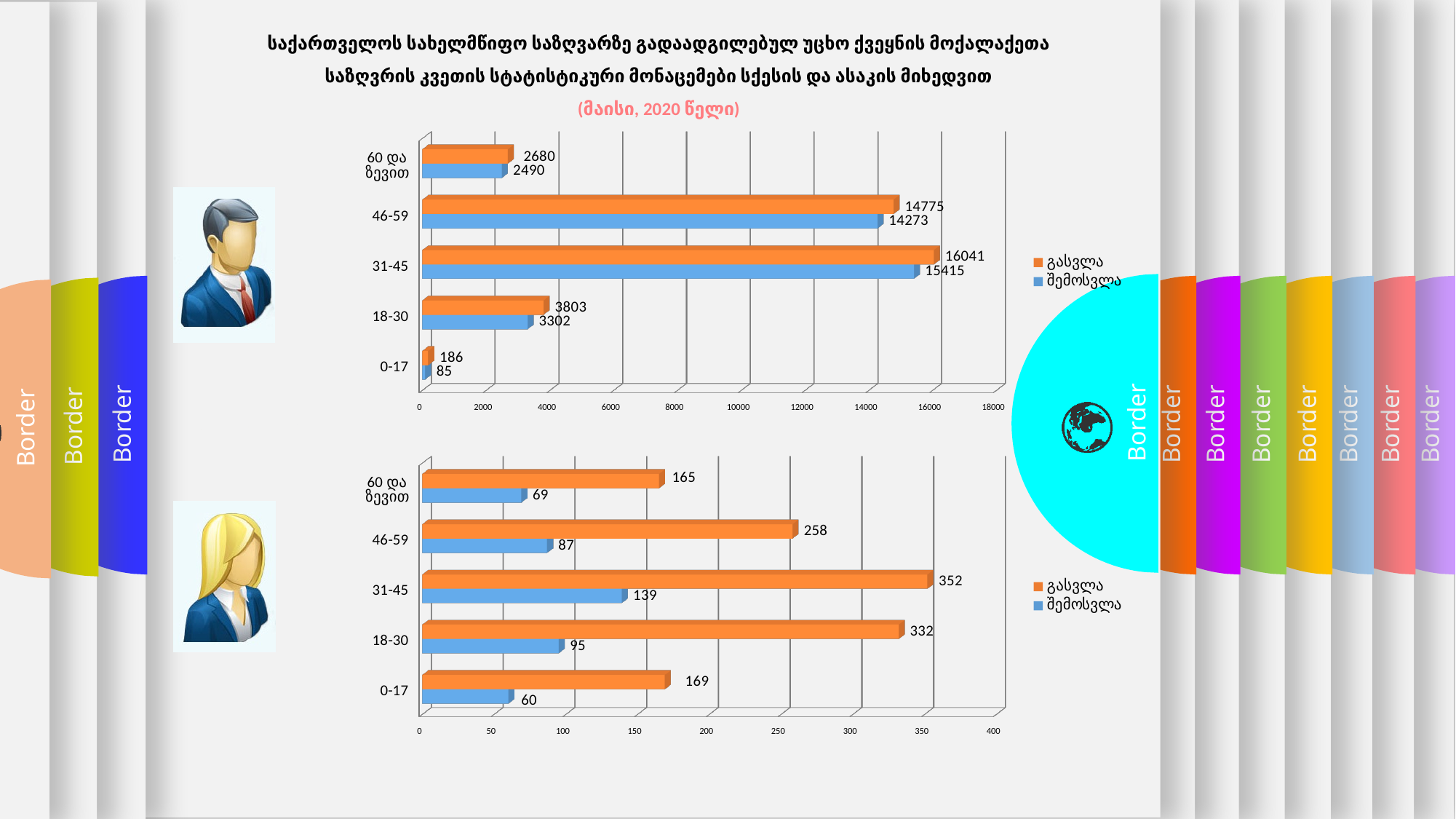
How many age groups are shown in the top chart? 5 In the bottom chart, what is the difference between გასვლა and შემოსვლა for the 31-45 age group? 213 In the bottom chart, which age group has the lowest შემოსვლა value? 0-17 How many series does the legend of the bottom chart list? 2 In the top chart, what is the value of შემოსვლა for the 0-17 age group? 85 What type of chart is the top chart? Bar chart In the top chart, what is the value of გასვლა for the 31-45 age group? 16041 In the top chart, what is the difference between გასვლა and შემოსვლა for the 46-59 age group? 502 In the bottom chart, what is the value of შემოსვლა for the 18-30 age group? 95 In the bottom chart, which is larger: გასვლა for 18-30 or გასვლა for 60 და ზევით? გასვლა for 18-30 In the bottom chart, what is the value of გასვლა for the 46-59 age group? 258 In the top chart, which age group has the highest გასვლა value? 31-45